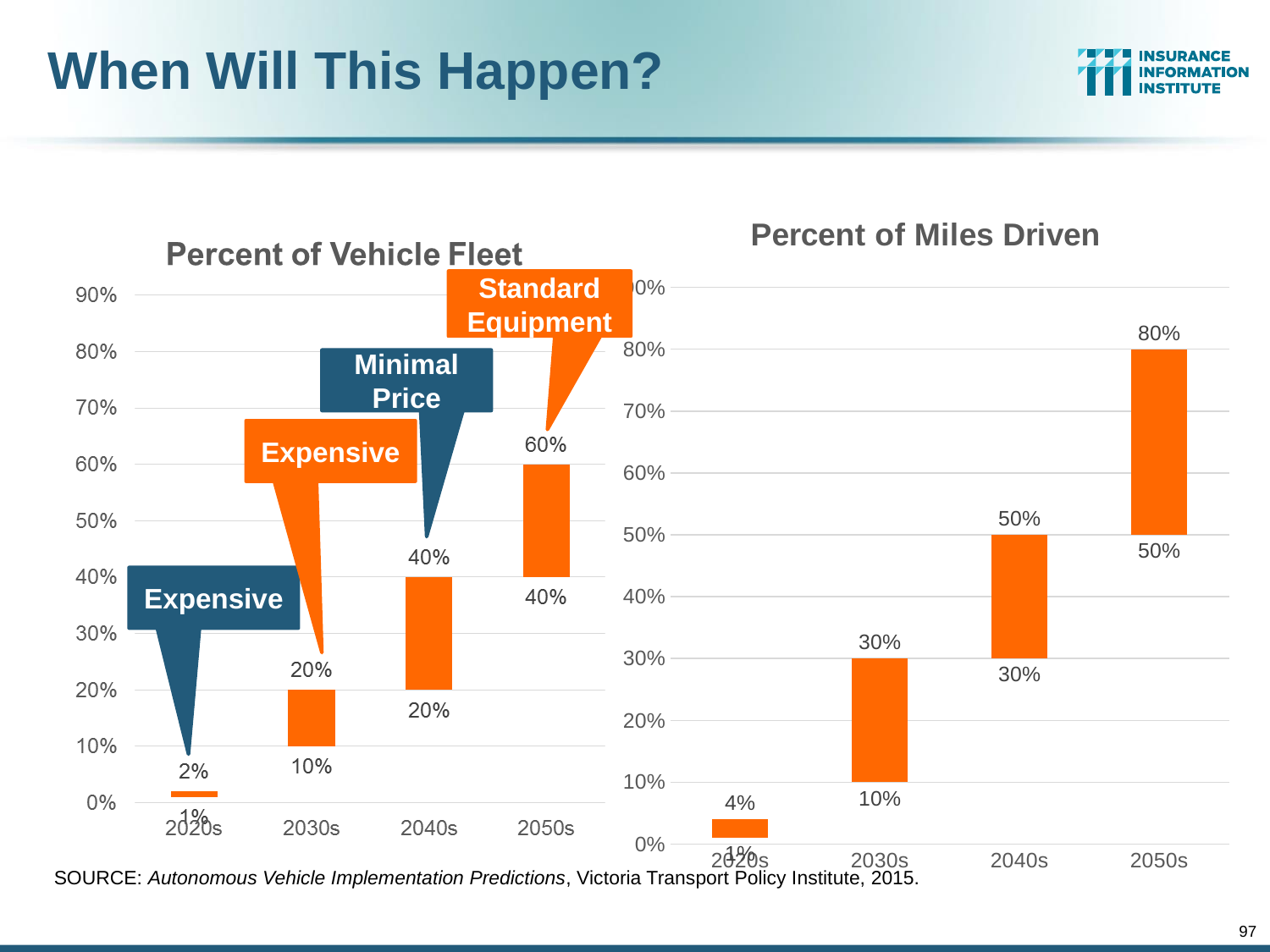
In the Percent of Miles Driven chart, what is the difference between the upper and lower values for the 2050s? 30% In the Percent of Vehicle Fleet chart, what is the lower value shown for the 2040s? 20% In the Percent of Miles Driven chart, what is the upper value shown for the 2020s? 4% In the Percent of Miles Driven chart, what is the lower value shown for the 2040s? 30% What kind of chart is the Percent of Miles Driven chart? Bar chart Which is larger: the upper value for the 2040s in the Percent of Vehicle Fleet chart or the upper value for the 2040s in the Percent of Miles Driven chart? Percent of Miles Driven In the Percent of Miles Driven chart, do the values rise or fall from the 2020s to the 2050s? Rise In the Percent of Vehicle Fleet chart, what is the upper value shown for the 2050s? 60% How many decades are shown on the x axis of the Percent of Vehicle Fleet chart? 4 In the Percent of Miles Driven chart, what is the upper value shown for the 2050s? 80% In the Percent of Vehicle Fleet chart, which decade has the highest upper value? 2050s In the Percent of Miles Driven chart, which decade has the lowest upper value? 2020s